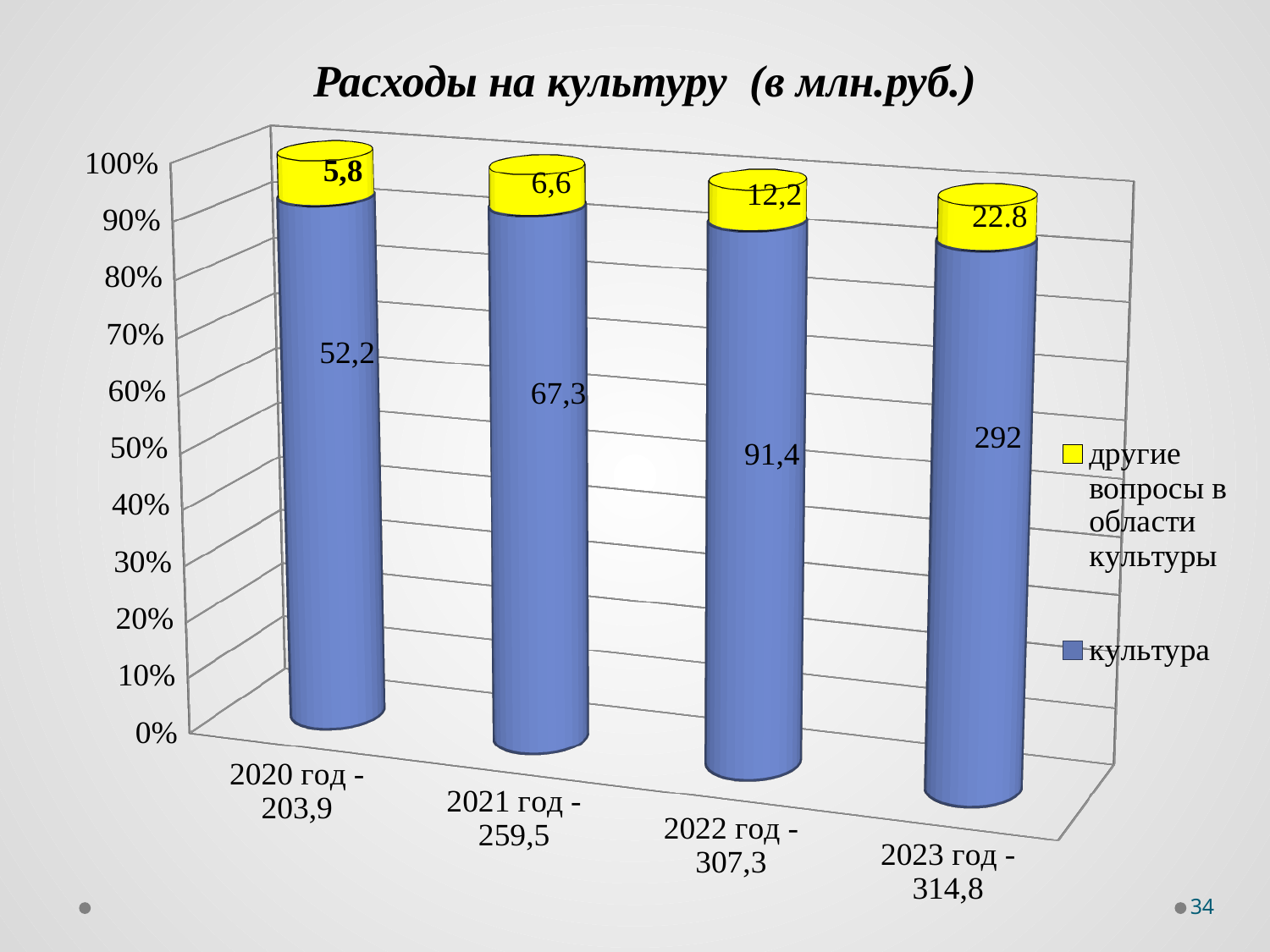
What is the difference between the культура values for 2021 год and 2020 год? 15,1 What is the value for культура in 2022 год? 91,4 In which year is the value for культура the lowest? 2020 год What is the value for другие вопросы в области культуры in 2023 год? 22.8 What kind of chart is shown on the slide? Stacked bar chart How many years are shown on the x axis? 4 In which year is the value for другие вопросы в области культуры the highest? 2023 год Do the values for культура rise or fall from 2020 год to 2023 год? Rise What is the value for культура in 2020 год? 52,2 What is the value for другие вопросы в области культуры in 2021 год? 6,6 How many series does the legend list? 2 Which is larger: the другие вопросы в области культуры value for 2022 год or for 2021 год? 2022 год